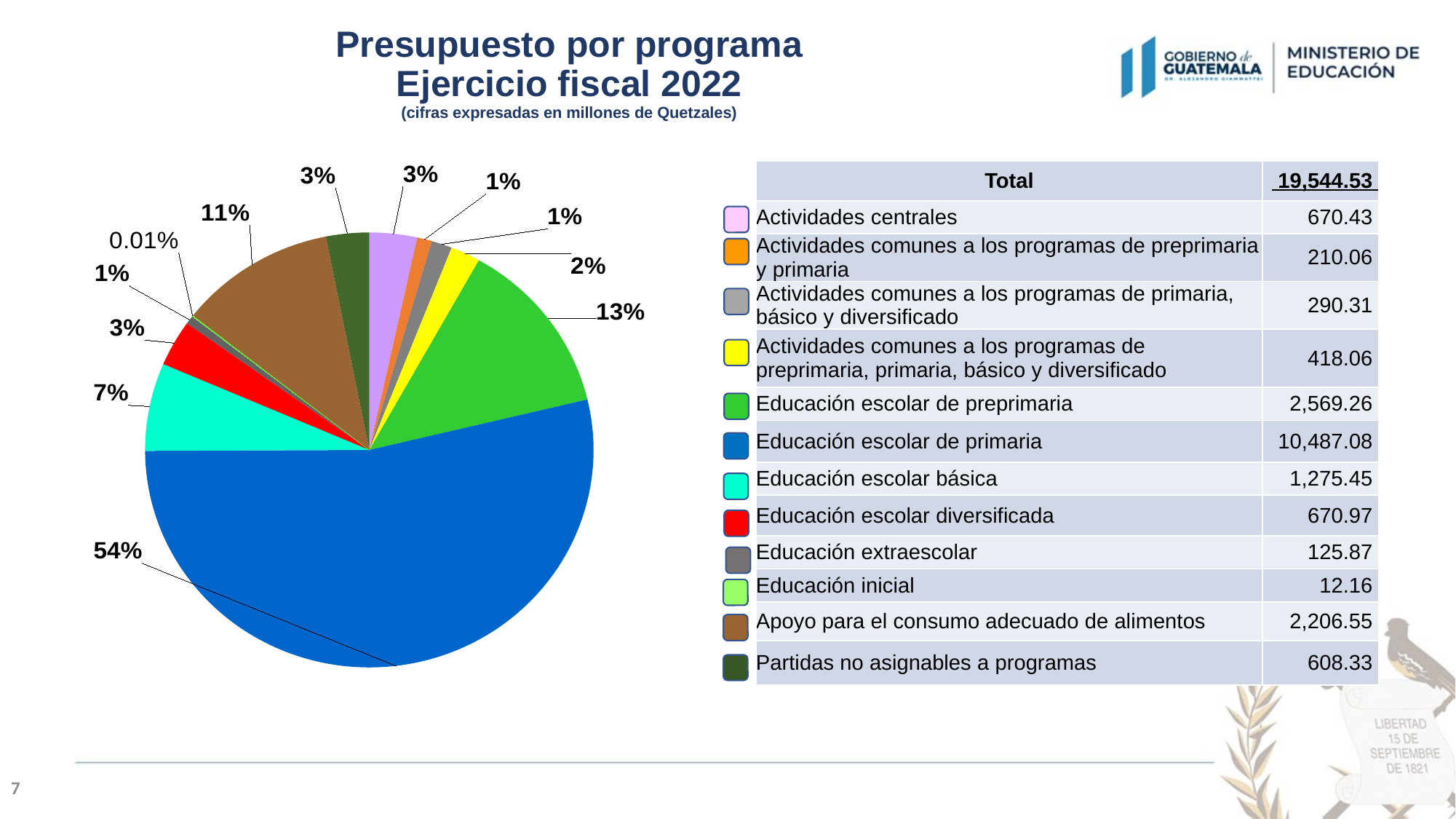
What share of the pie does Educación escolar de primaria represent? 54% What is the value for Educación escolar básica? 1,275.45 What is the difference between the values for Educación escolar de preprimaria and Apoyo para el consumo adecuado de alimentos? 362.71 What is the total shown for all programs? 19,544.53 What is the value for Partidas no asignables a programas? 608.33 What share of the pie does Apoyo para el consumo adecuado de alimentos represent? 11% Which category has the smallest value? Educación inicial How many categories (slices) does the pie chart have? 12 What share of the pie does Educación escolar de preprimaria represent? 13% Which is larger, the value for Educación escolar diversificada or the value for Actividades centrales? Educación escolar diversificada Which category has the largest value? Educación escolar de primaria What kind of chart is shown on the slide? pie chart